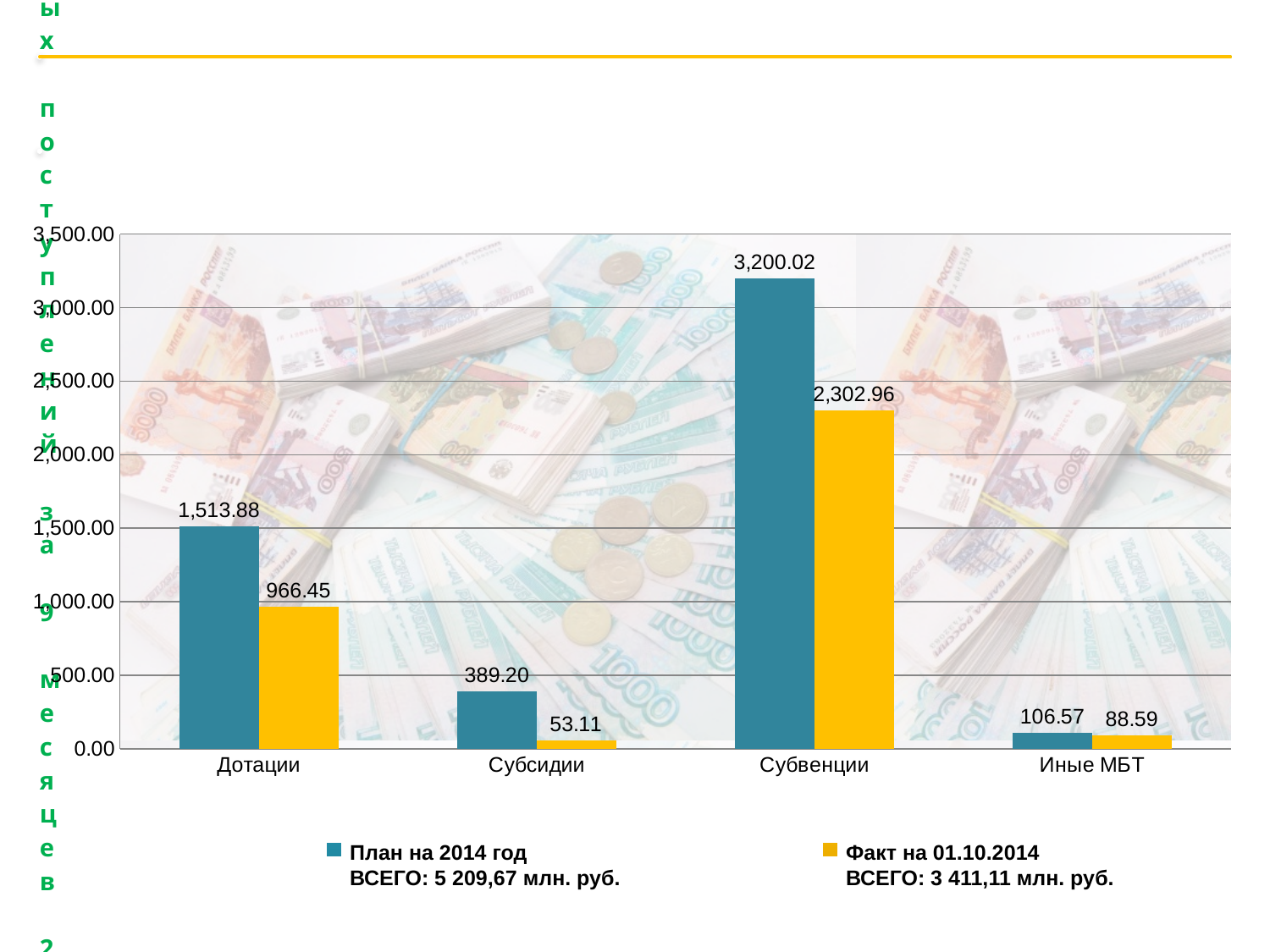
Which category has the lowest value for Факт на 01.10.2014? Субсидии How many categories are shown on the x axis? 4 What is the difference between План на 2014 год and Факт на 01.10.2014 for Субвенции? 897.06 What is the value of План на 2014 год for Иные МБТ? 106.57 What is the value of Факт на 01.10.2014 for Дотации? 966.45 Which category has the highest value for План на 2014 год? Субвенции What is the value of План на 2014 год for Субвенции? 3,200.02 Which is larger: План на 2014 год for Дотации or Факт на 01.10.2014 for Субвенции? Факт на 01.10.2014 for Субвенции What total is stated in the legend for Факт на 01.10.2014? 3 411,11 млн. руб. How many series does the legend list? 2 What is the value of Факт на 01.10.2014 for Субсидии? 53.11 What kind of chart is shown on the slide? Bar chart